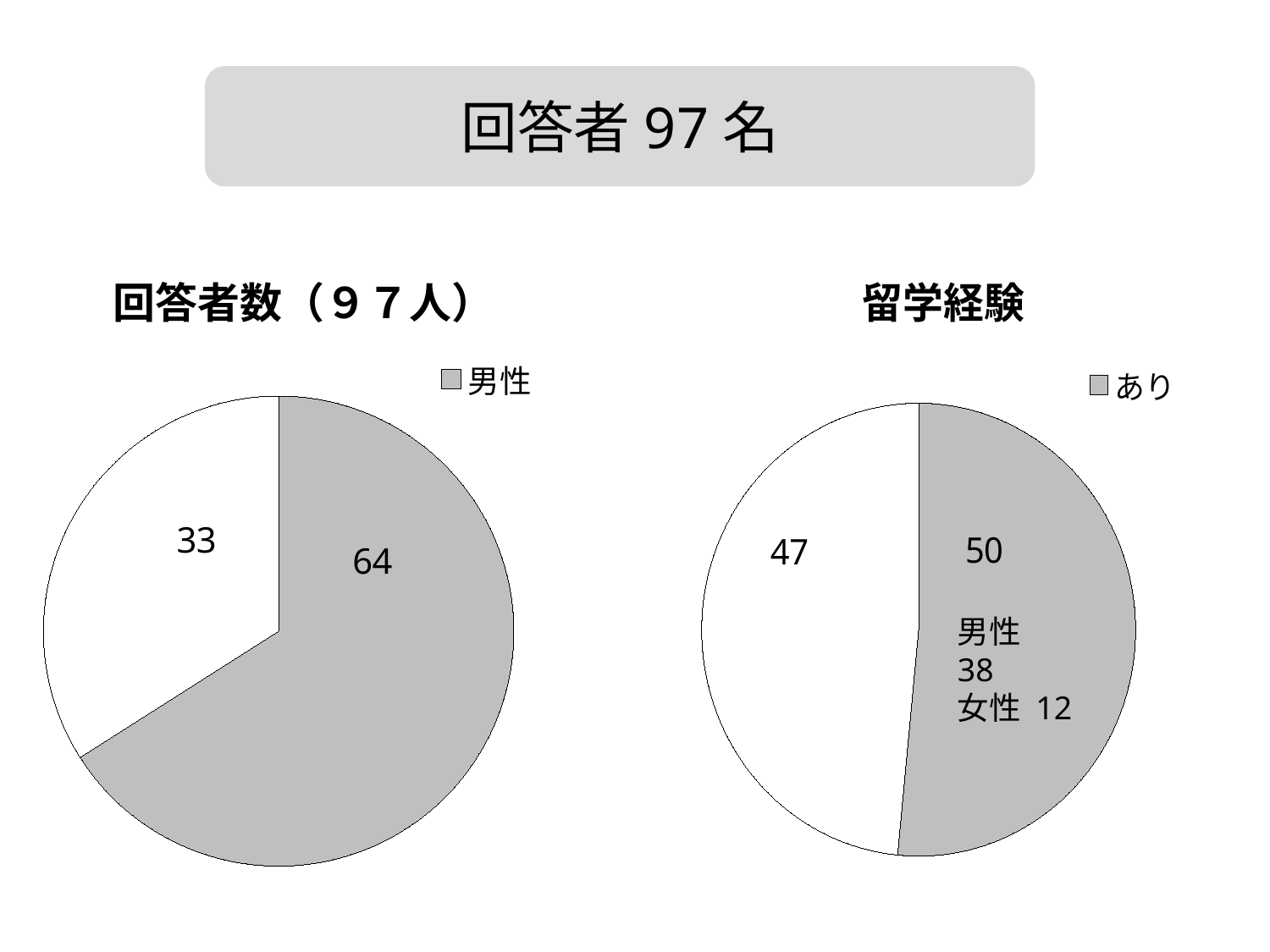
In the right pie chart titled 留学経験, what is the value of the あり slice? 50 In the left pie chart titled 回答者数（９７人）, what is the difference between the two slices (64 and 33)? 31 How many slices does the right pie chart titled 留学経験 have? 2 In the right pie chart titled 留学経験, how many 女性 are noted within the あり slice? 12 In the right pie chart titled 留学経験, how many 男性 are noted within the あり slice? 38 In the right pie chart titled 留学経験, what is the value of the white slice? 47 In the right pie chart titled 留学経験, what is the difference between the あり slice and the white slice? 3 What is the single legend entry shown for the right pie chart titled 留学経験? あり In the left pie chart titled 回答者数（９７人）, which slice is larger, the 男性 slice or the white slice? 男性 In the left pie chart titled 回答者数（９７人）, what is the value of the white slice? 33 What kind of chart is the left chart titled 回答者数（９７人）? pie chart In the left pie chart titled 回答者数（９７人）, what is the value of the 男性 slice? 64